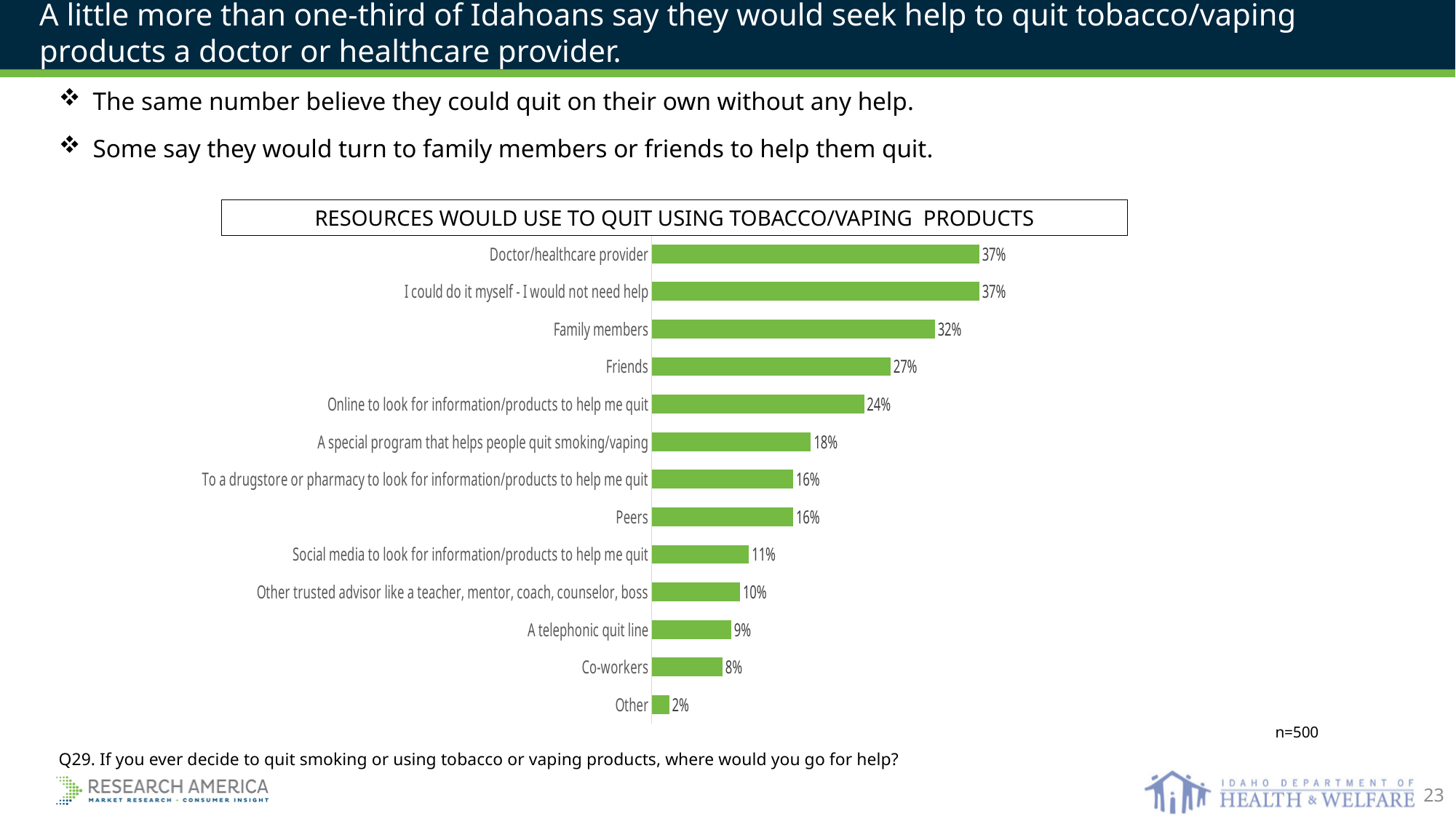
What is the value for 'Family members'? 32% What is the title of the chart? RESOURCES WOULD USE TO QUIT USING TOBACCO/VAPING PRODUCTS What type of chart is shown on the slide? Bar chart What is the difference between the values for 'Family members' and 'Friends'? 5% What percentage said they would go online to look for information/products to help them quit? 24% What is the difference between the values for 'Doctor/healthcare provider' and 'Co-workers'? 29% What is the value for 'A telephonic quit line'? 9% Which category has the lowest value in the chart? Other Which is larger: the value for 'Peers' or the value for 'Social media to look for information/products to help me quit'? Peers Which is larger: the value for 'A special program that helps people quit smoking/vaping' or the value for 'Friends'? Friends How many categories are shown in the chart? 13 What percentage of respondents said they would use a doctor/healthcare provider to quit using tobacco/vaping products? 37%